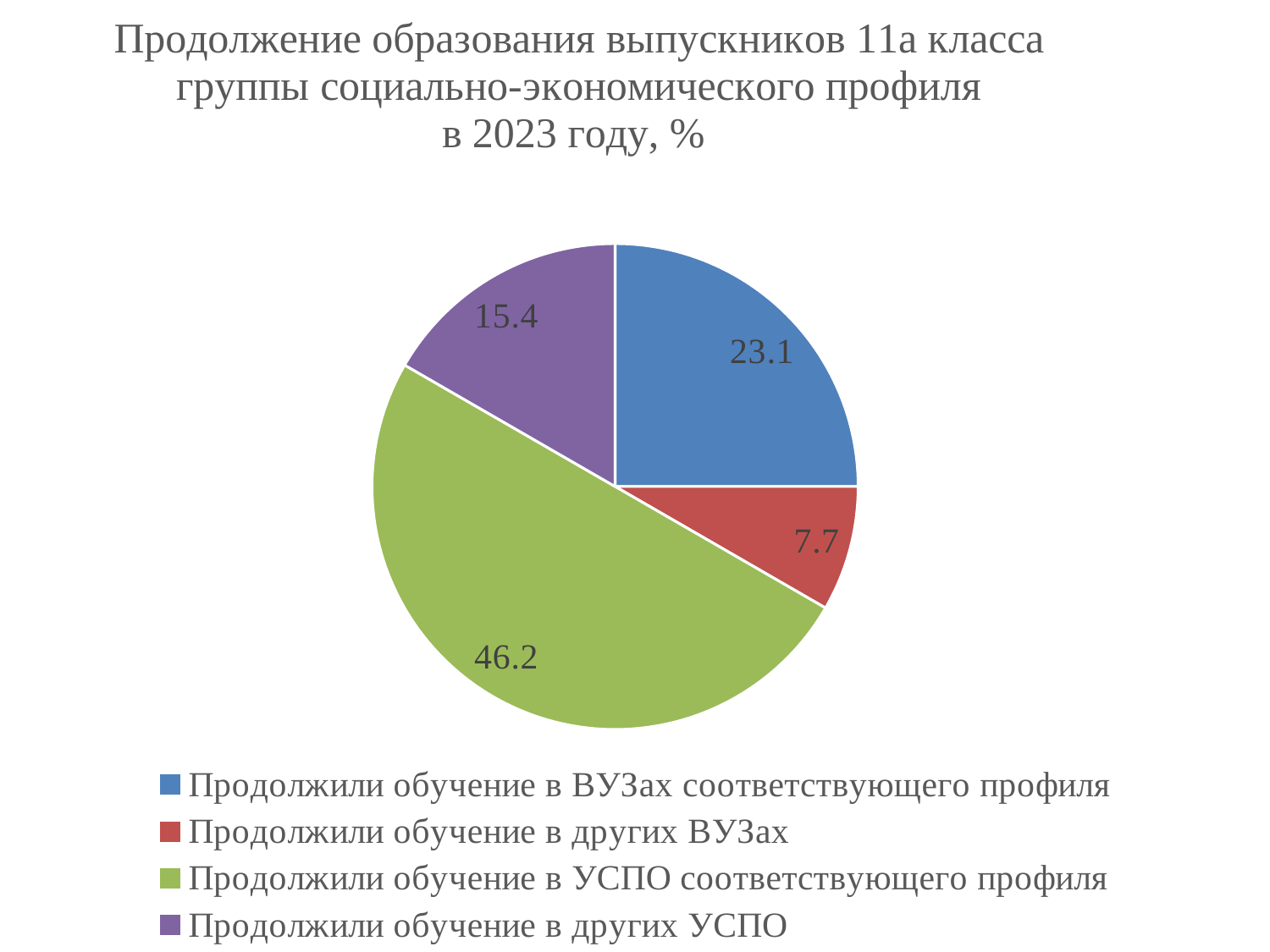
Which category has the smallest share of the pie? Продолжили обучение в других ВУЗах What colour is the slice for "Продолжили обучение в других ВУЗах"? red Which category has the largest share of the pie? Продолжили обучение в УСПО соответствующего профиля What type of chart is shown on the slide? pie chart What is the value for "Продолжили обучение в других ВУЗах"? 7.7 What is the value for "Продолжили обучение в других УСПО"? 15.4 What is the value for "Продолжили обучение в УСПО соответствующего профиля"? 46.2 What is the difference between the values for "Продолжили обучение в УСПО соответствующего профиля" and "Продолжили обучение в ВУЗах соответствующего профиля"? 23.1 How many entries does the legend list? 4 Which is larger: the value for "Продолжили обучение в ВУЗах соответствующего профиля" or for "Продолжили обучение в других УСПО"? Продолжили обучение в ВУЗах соответствующего профиля How many slices does the pie chart have? 4 What is the value for "Продолжили обучение в ВУЗах соответствующего профиля"? 23.1